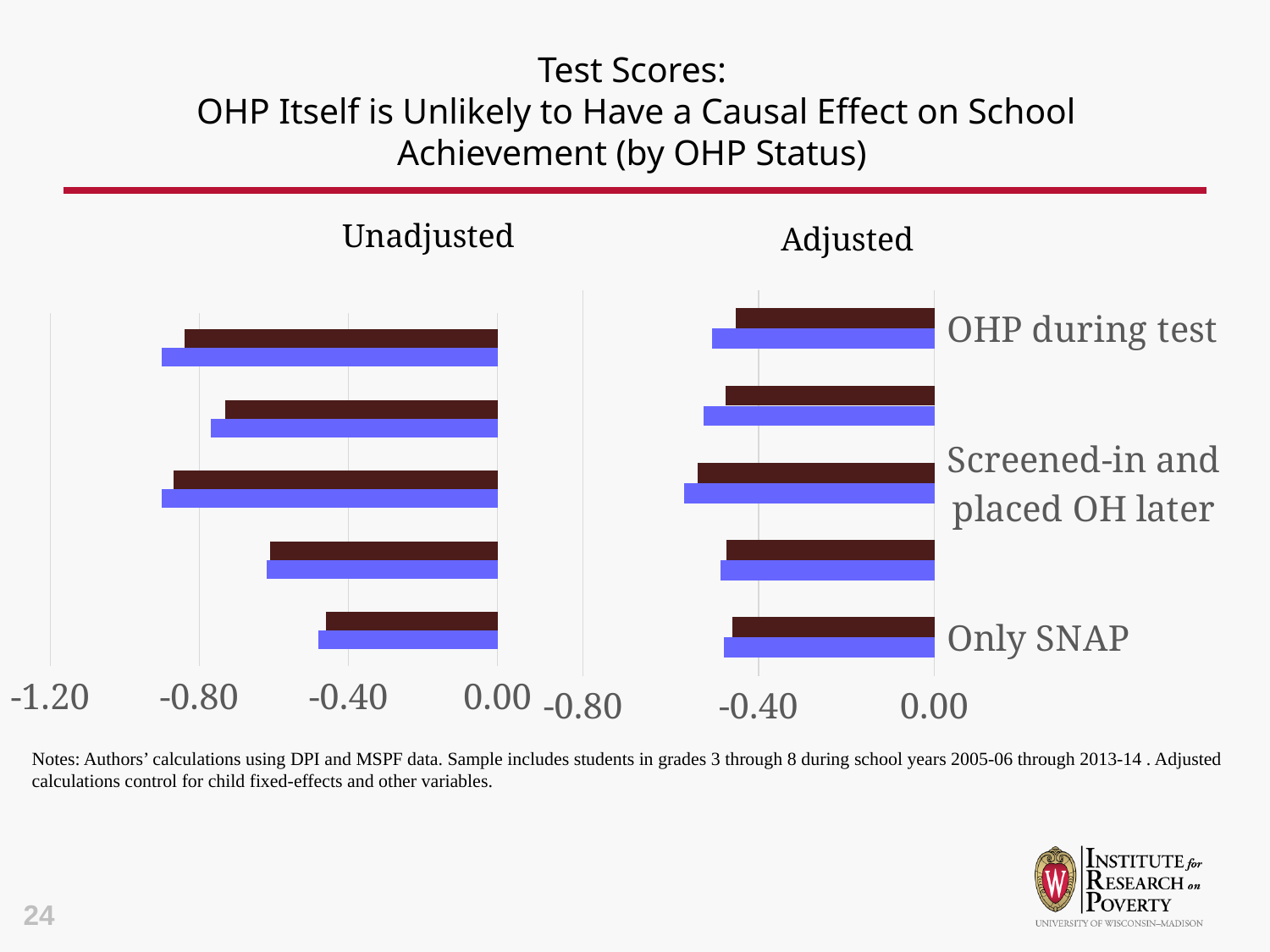
In the Unadjusted chart, which labeled category has the shortest bars (values closest to zero)? Only SNAP How many pairs of bars (categories) are plotted in the Adjusted chart? 5 What kind of chart is the Unadjusted chart? bar chart In the Adjusted chart, is the value of the dark bar for OHP during test greater or less than -0.80? greater In the Adjusted chart, is the value of the blue bar for Screened-in and placed OH later greater or less than -0.40? less In the Unadjusted chart, is the value of the dark bar for Only SNAP greater or less than -0.40? less In the Unadjusted chart, which blue bar extends further from zero: OHP during test or Only SNAP? OHP during test What are the titles of the two charts on the slide? Unadjusted and Adjusted What is the leftmost axis tick label on the Unadjusted chart? -1.20 In the Adjusted chart, which labeled category has the blue bar extending furthest from zero? Screened-in and placed OH later How many bars are shown for each category in the Unadjusted chart? 2